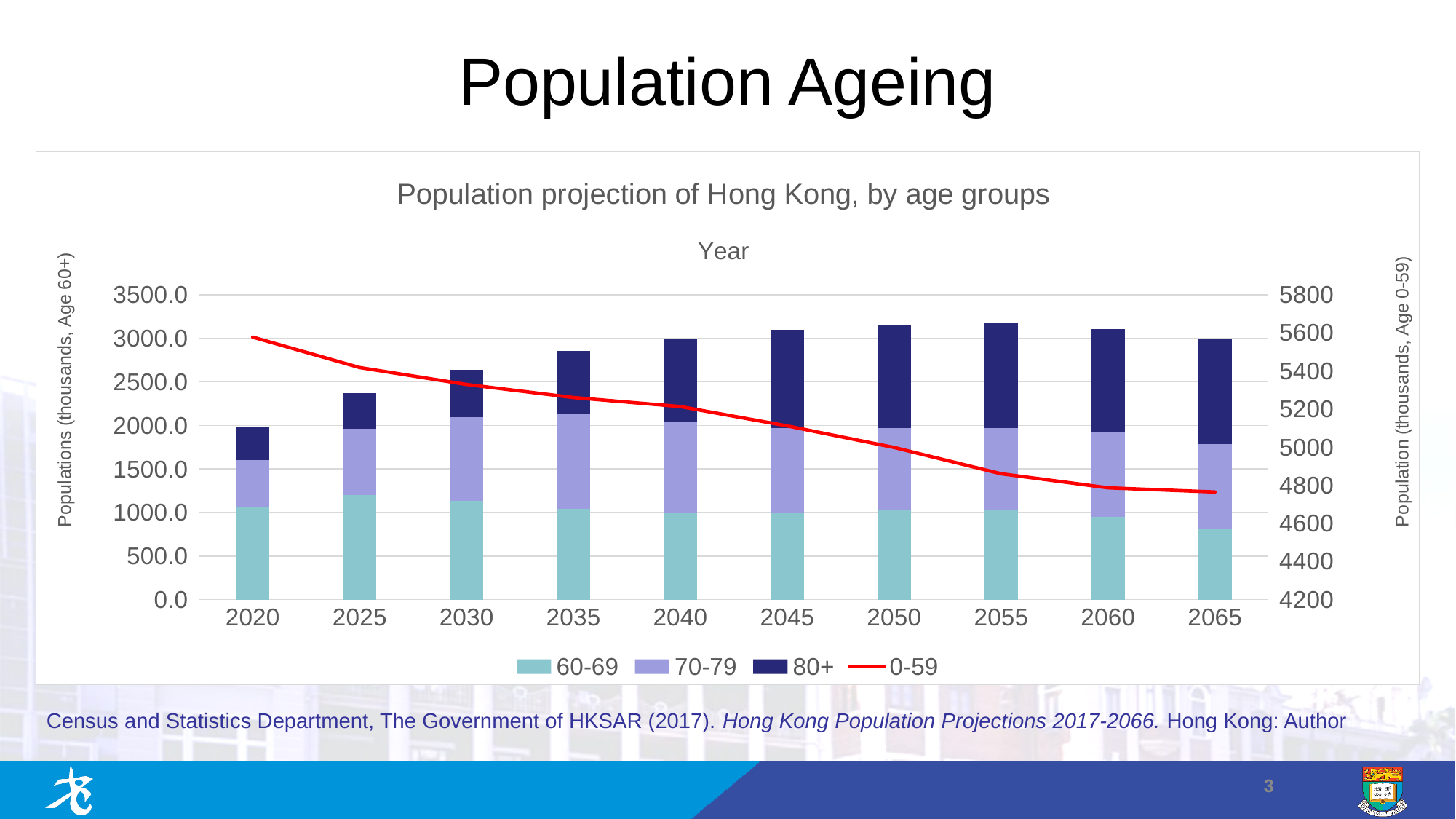
In which year is the 0-59 population highest? 2020 How many years are shown on the x axis? 10 Is the total stacked bar for 2025 greater or less than 2500.0? less Does the 0-59 line rise or fall from 2020 to 2065? Fall Which age group is plotted as a line rather than bars? 0-59 Is the 0-59 value for 2055 greater or less than 5000? less What is the title of the chart? Population projection of Hong Kong, by age groups In which year is the total stacked bar (age 60+) lowest? 2020 How many series does the legend list? 4 What kind of chart is used for the 60-69, 70-79 and 80+ age groups? Stacked bar chart Is the 0-59 value for 2020 greater or less than 5400? greater